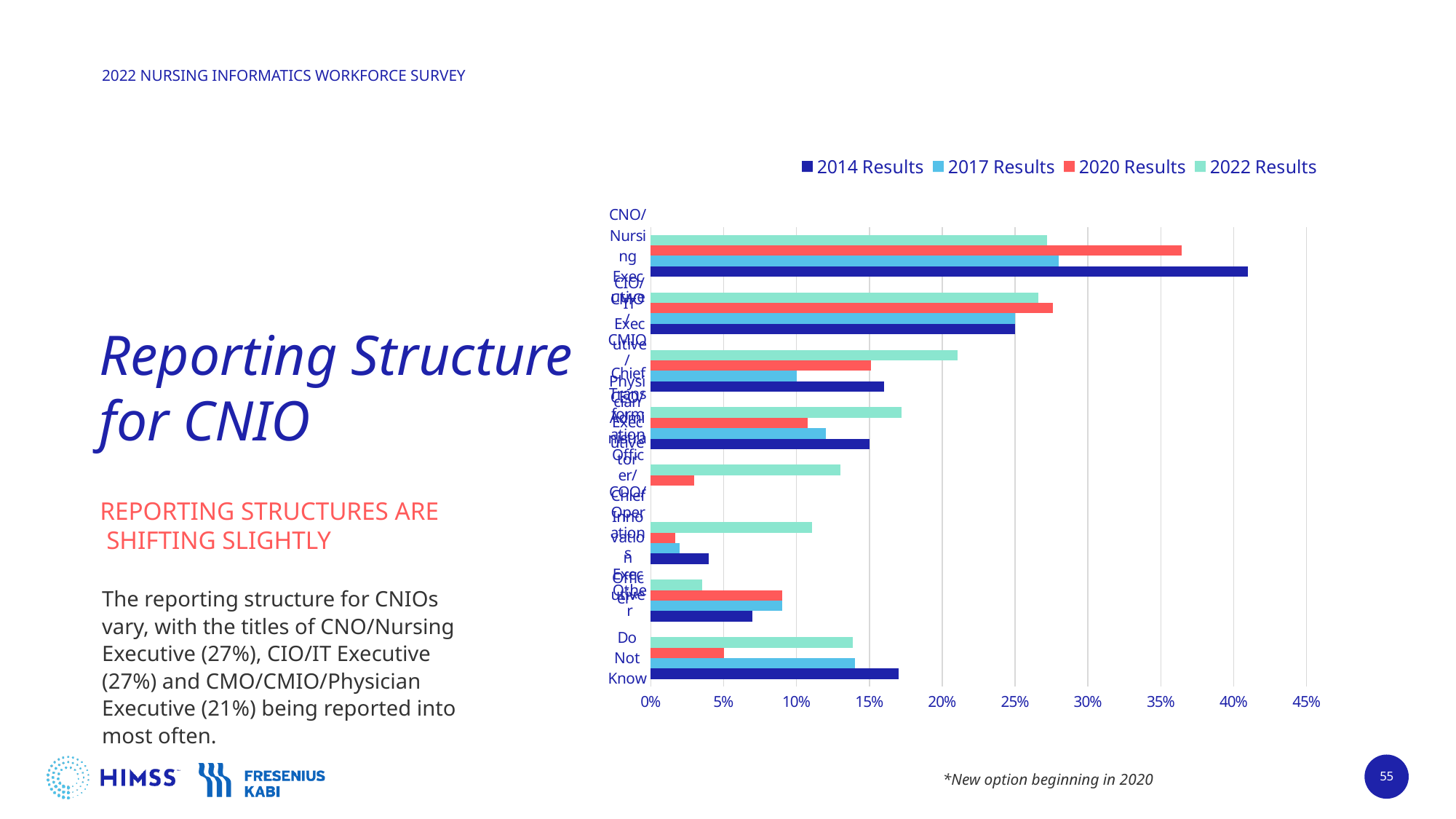
How many series does the chart legend list? 4 What kind of chart is shown on the slide? bar chart Is the 2014 Results value for CNO/Nursing Executive greater or less than 40%? greater Is the 2014 Results value for Do Not Know greater or less than 15%? greater Is the 2022 Results value for Other greater or less than 5%? less Which series has the highest value for CNO/Nursing Executive? 2014 Results Which category has the highest 2014 Results value? CNO/Nursing Executive Which is larger for CNO/Nursing Executive: the 2014 Results value or the 2022 Results value? 2014 Results How many categories are plotted on the chart? 8 What is the highest percentage shown on the chart's x axis? 45% Which is larger for Do Not Know: the 2020 Results value or the 2022 Results value? 2022 Results